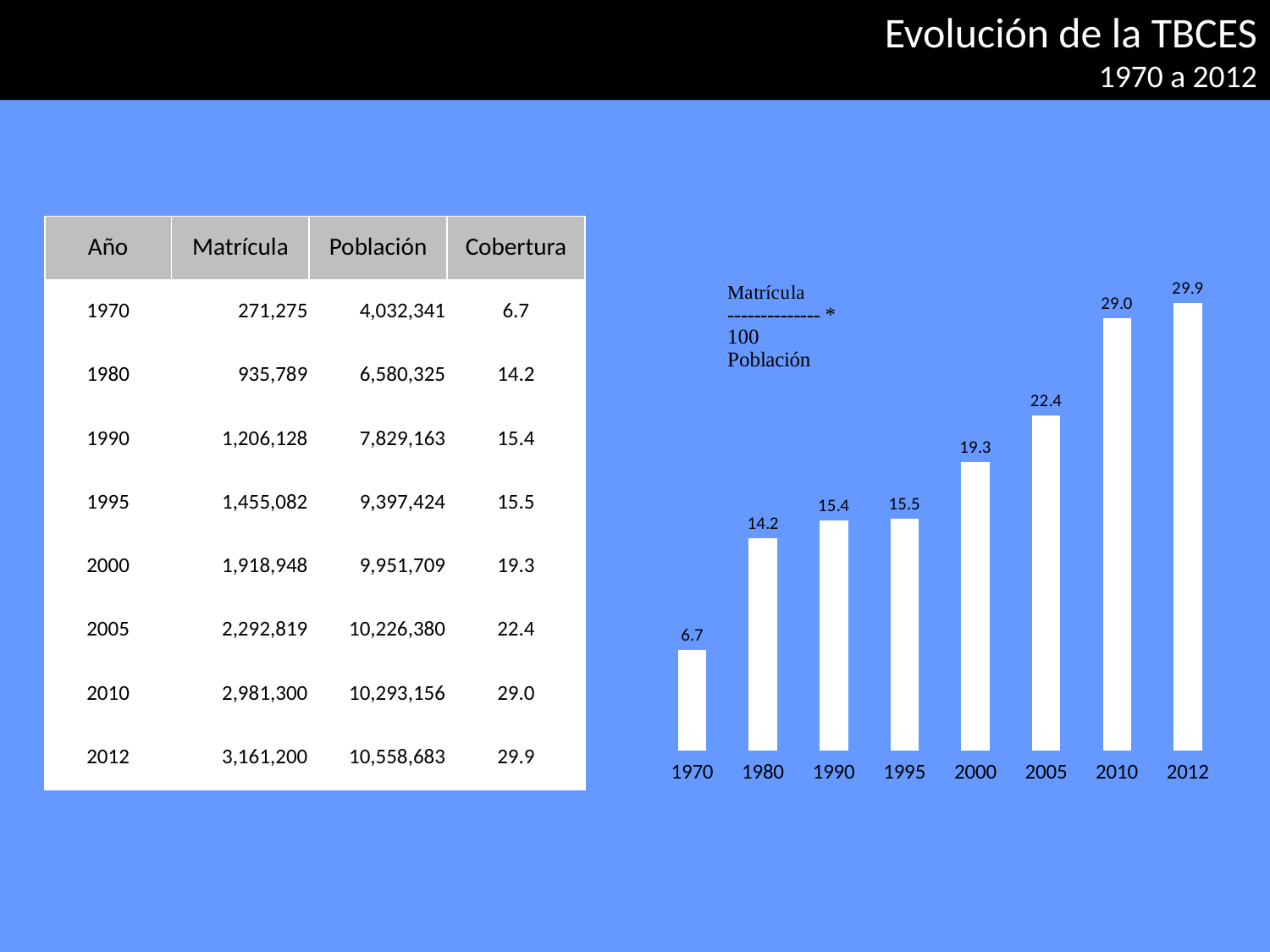
What kind of chart is shown on the slide? bar chart What colour are the bars in the chart? white How many years are shown on the x axis of the bar chart? 8 What is the value shown for 1970 in the bar chart? 6.7 What is the value shown for 2000 in the bar chart? 19.3 What is the difference between the values for 2010 and 2005 in the bar chart? 6.6 What is the difference between the values for 2012 and 1970 in the bar chart? 23.2 What is the value shown for 2005 in the bar chart? 22.4 Which year has the lowest value in the bar chart? 1970 Which is larger in the bar chart, the value for 1980 or the value for 2000? 2000 Which year has the highest value in the bar chart? 2012 Do the values in the bar chart rise or fall from 1970 to 2012? rise